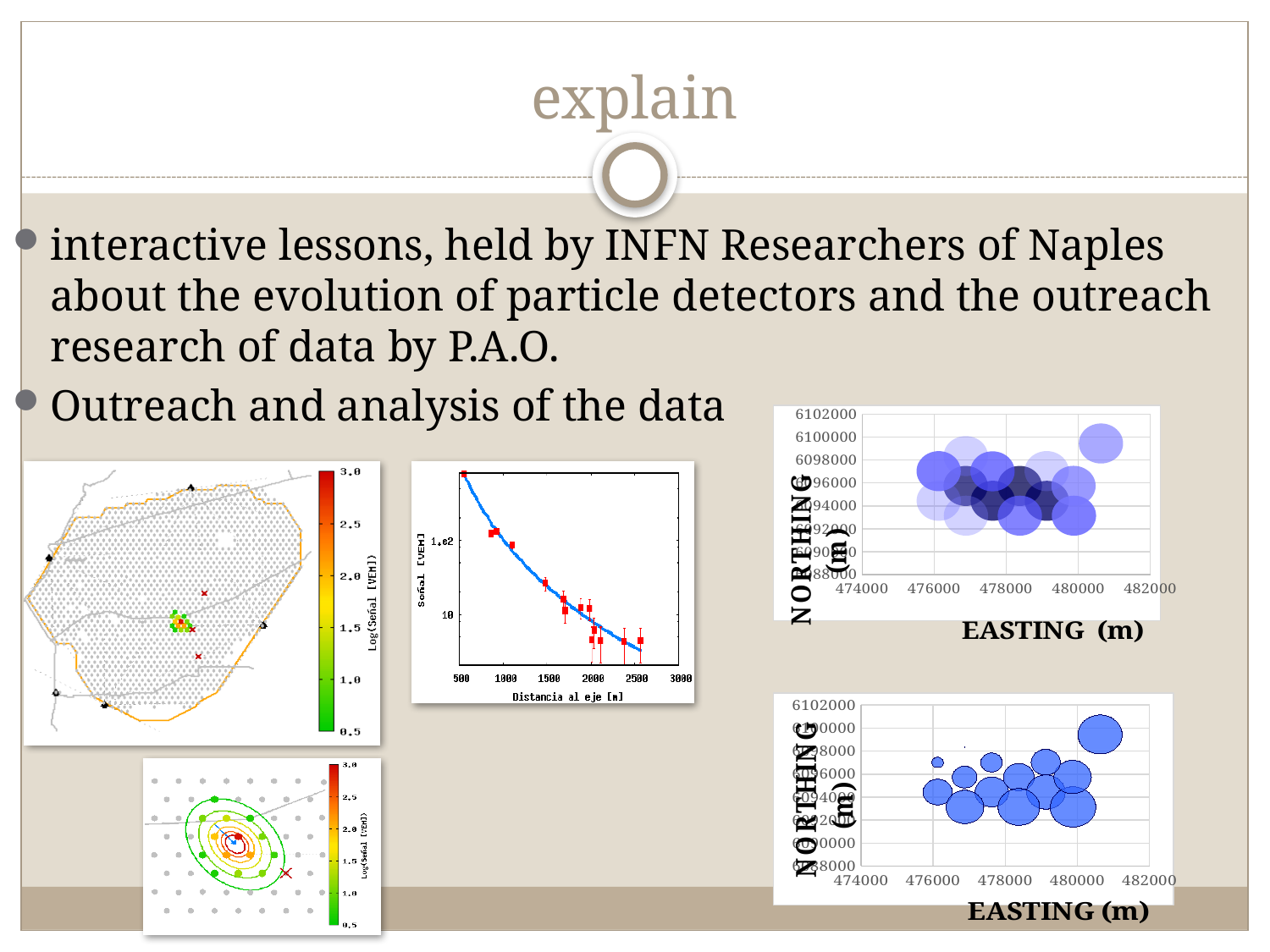
What is the x-axis label of the middle chart with the blue fitted curve? Distancia al eje [m] What is the highest NORTHING tick shown on the y axis of the bubble charts on the right? 6102000 In the middle chart (Señal vs Distancia al eje), is the signal value at about 2500 m greater or less than 10? less What kind of chart are the two charts on the right side of the slide with NORTHING and EASTING axes? bubble chart What is the maximum value on the colour scale of the detector array map on the left? 3.0 What is the lowest EASTING tick shown on the x axis of the bubble charts on the right? 474000 What is the y-axis label of the two bubble charts on the right? NORTHING (m) What is the highest EASTING tick shown on the x axis of the bubble charts on the right? 482000 What is the largest distance tick shown on the x axis of the middle chart (Señal vs Distancia al eje)? 3000 In the middle chart (Señal vs Distancia al eje), do the plotted values rise or fall as the distance increases? fall In the middle chart (Señal vs Distancia al eje), is the signal value at 500 m greater or less than 1.e2? greater What is the minimum value on the colour scale of the detector array map on the left? 0.5